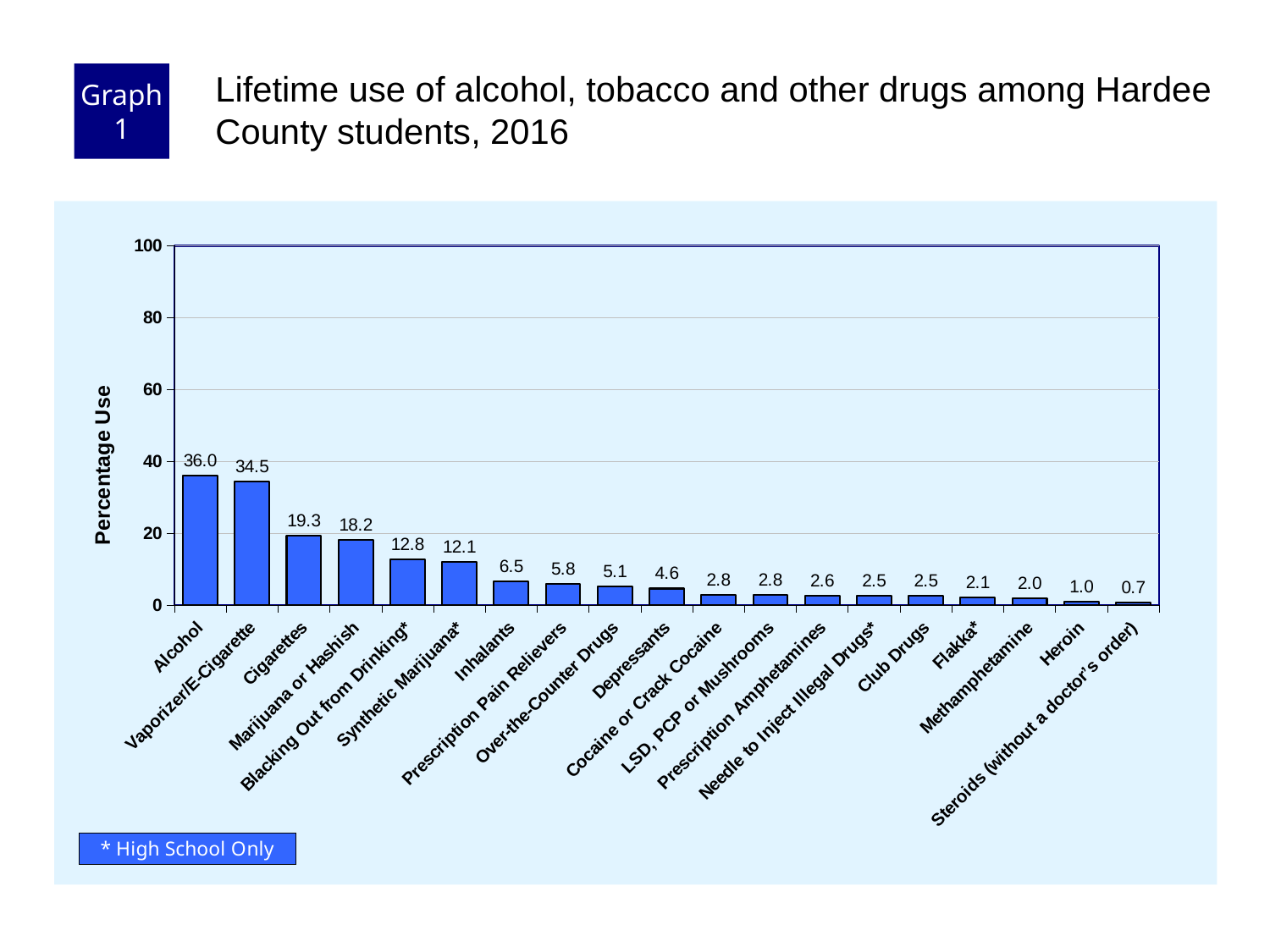
Which has a higher percentage use, Inhalants or Prescription Pain Relievers? Inhalants Do the values rise or fall moving left to right along the x axis? Fall How many categories are shown on the x axis? 19 What kind of chart is shown on the slide? Bar chart What is the percentage use for Heroin? 1.0 What is the difference in percentage use between Cigarettes and Marijuana or Hashish? 1.1 What is the percentage use for Vaporizer/E-Cigarette? 34.5 What is the percentage use for Alcohol? 36.0 What is the percentage use for Synthetic Marijuana*? 12.1 Which category has the highest percentage use? Alcohol Which category has the lowest percentage use? Steroids (without a doctor's order) What is the label of the y axis? Percentage Use